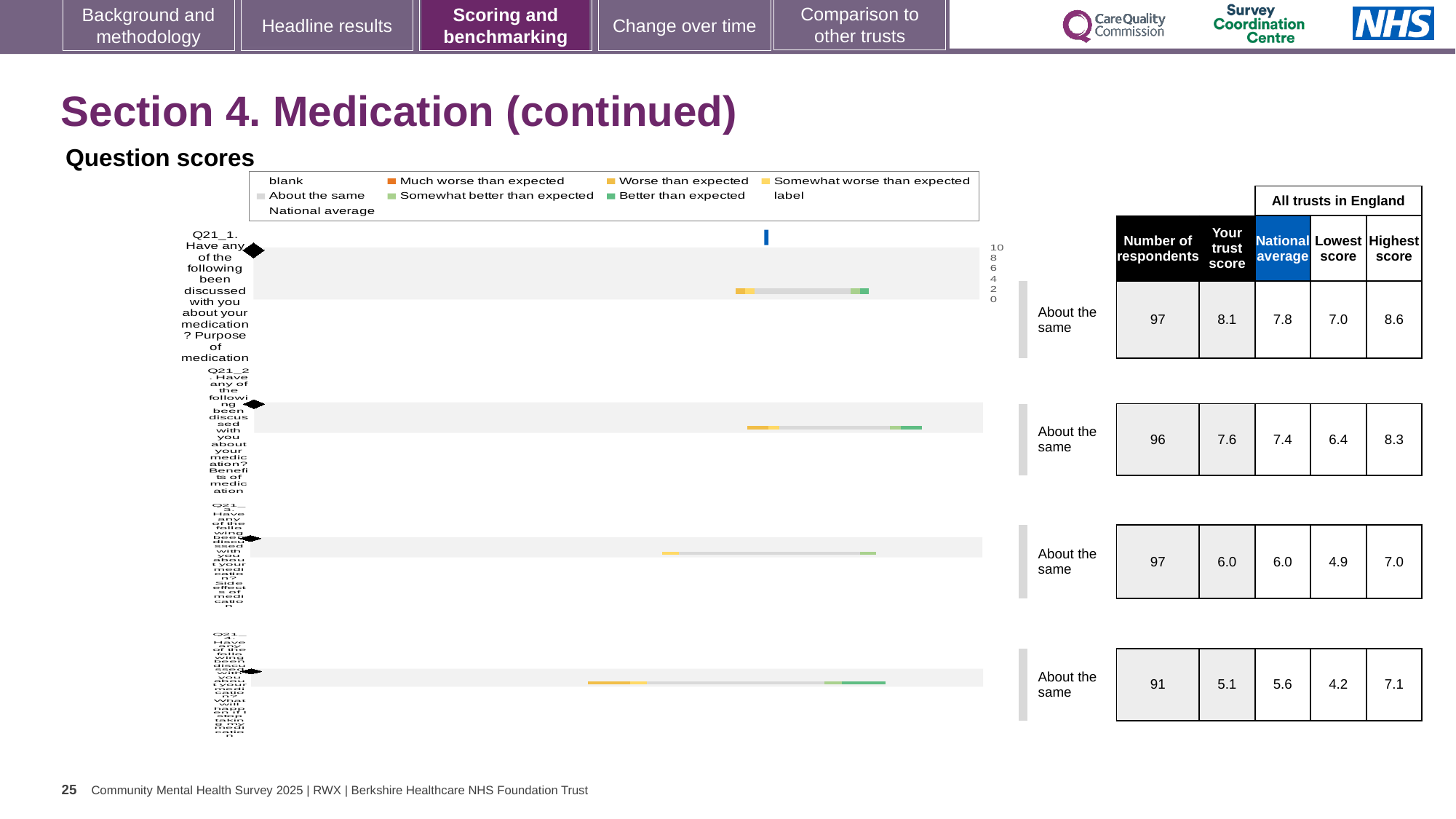
According to the table, how many respondents answered Q21_4? 91 Which question has the highest 'Your trust score' in the table? Q21_1 (8.1) Which question has the lowest 'Your trust score' in the table? Q21_4 (5.1) How many entries does the legend above the question score charts list? 9 According to the table, what is the national average for Q21_2 (Benefits of medication)? 7.4 What kind of chart is used to show the question scores on this slide? bar chart For Q21_1, which is larger: the trust score or the national average? the trust score (8.1) How many question charts (Q21_1 to Q21_4) are shown on the slide? 4 For Q21_3, what is the difference between the highest score and the lowest score in the table? 2.1 According to the table, what is the 'Your trust score' for Q21_1 (Purpose of medication)? 8.1 What benchmark category is shown next to each of the four question charts? About the same For Q21_4, what is the difference between the national average and the trust score? 0.5